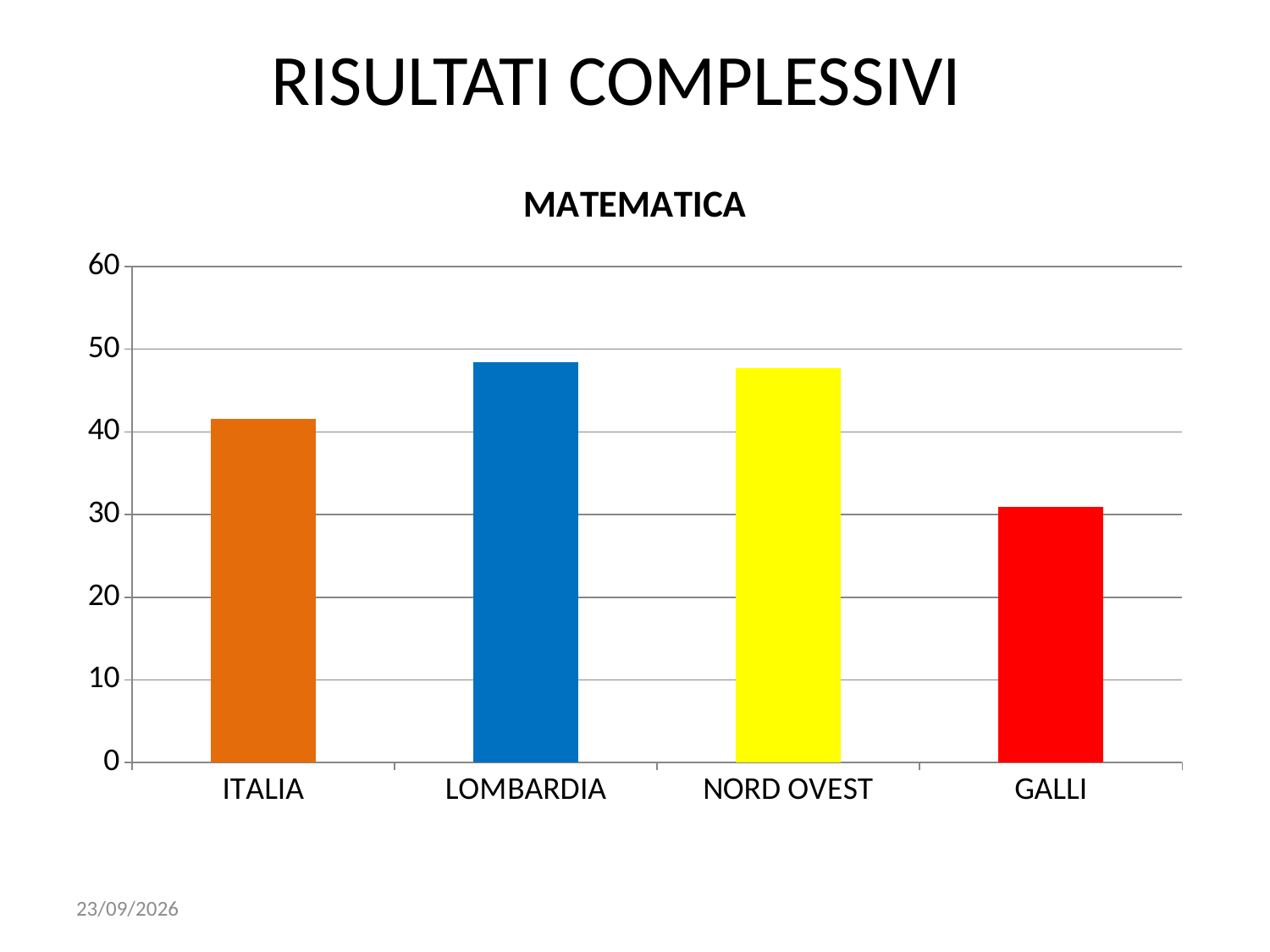
Which is larger, the value for ITALIA or the value for GALLI? ITALIA Is the value for NORD OVEST greater or less than 50? less Is the value for ITALIA greater or less than 50? less Is the value for LOMBARDIA greater or less than 40? greater What colour is the bar for NORD OVEST? yellow How many categories are shown on the x axis of the chart? 4 Which category has the lowest value in the chart? GALLI What is the title of the chart? MATEMATICA What kind of chart is shown on the slide? bar chart Which is larger, the value for LOMBARDIA or the value for ITALIA? LOMBARDIA